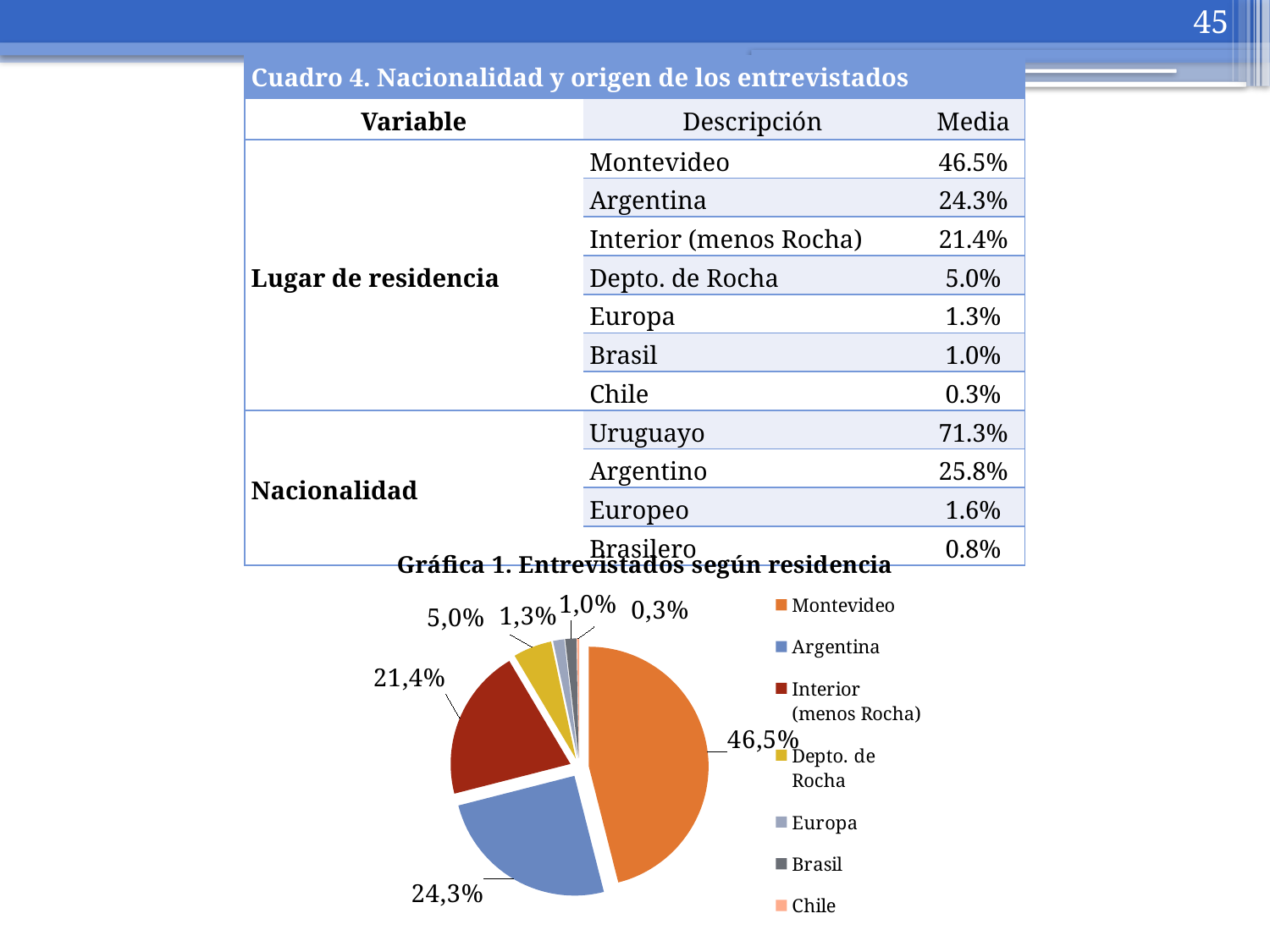
Which is larger, the share for Argentina or the share for Interior (menos Rocha)? Argentina What is the difference between the Montevideo share and the Argentina share? 22,2% What kind of chart is shown on the slide? pie chart Which category has the largest slice of the pie? Montevideo What colour is the Montevideo slice in the pie chart? orange What share of the pie does Montevideo have? 46,5% What share of the pie does Interior (menos Rocha) have? 21,4% How many categories does the legend of the pie chart list? 7 What share of the pie does Argentina have? 24,3% What share of the pie does Depto. de Rocha have? 5,0% What is the title of the chart? Gráfica 1. Entrevistados según residencia Which category has the smallest slice of the pie? Chile